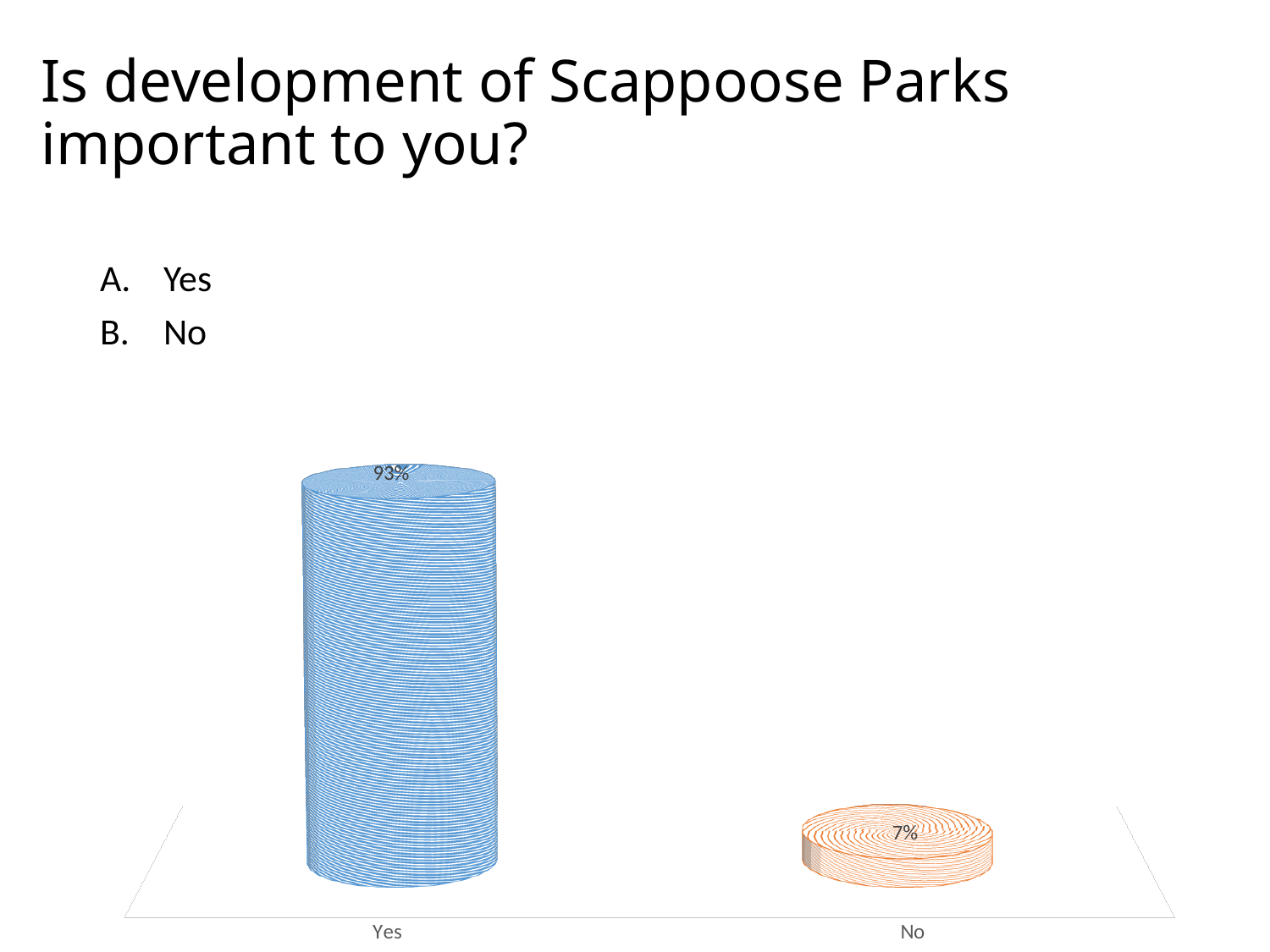
What is the value for Yes? 93% What is the difference between the values for Yes and No? 86% Which category has the lowest value? No How many categories are shown on the chart? 2 What colour is the bar for Yes? Blue What question does the slide title ask? Is development of Scappoose Parks important to you? Which is larger, the value for Yes or the value for No? Yes What kind of chart is shown on the slide? Bar chart What is the value for No? 7% Which category has the highest value? Yes What is the total of the values for Yes and No? 100%